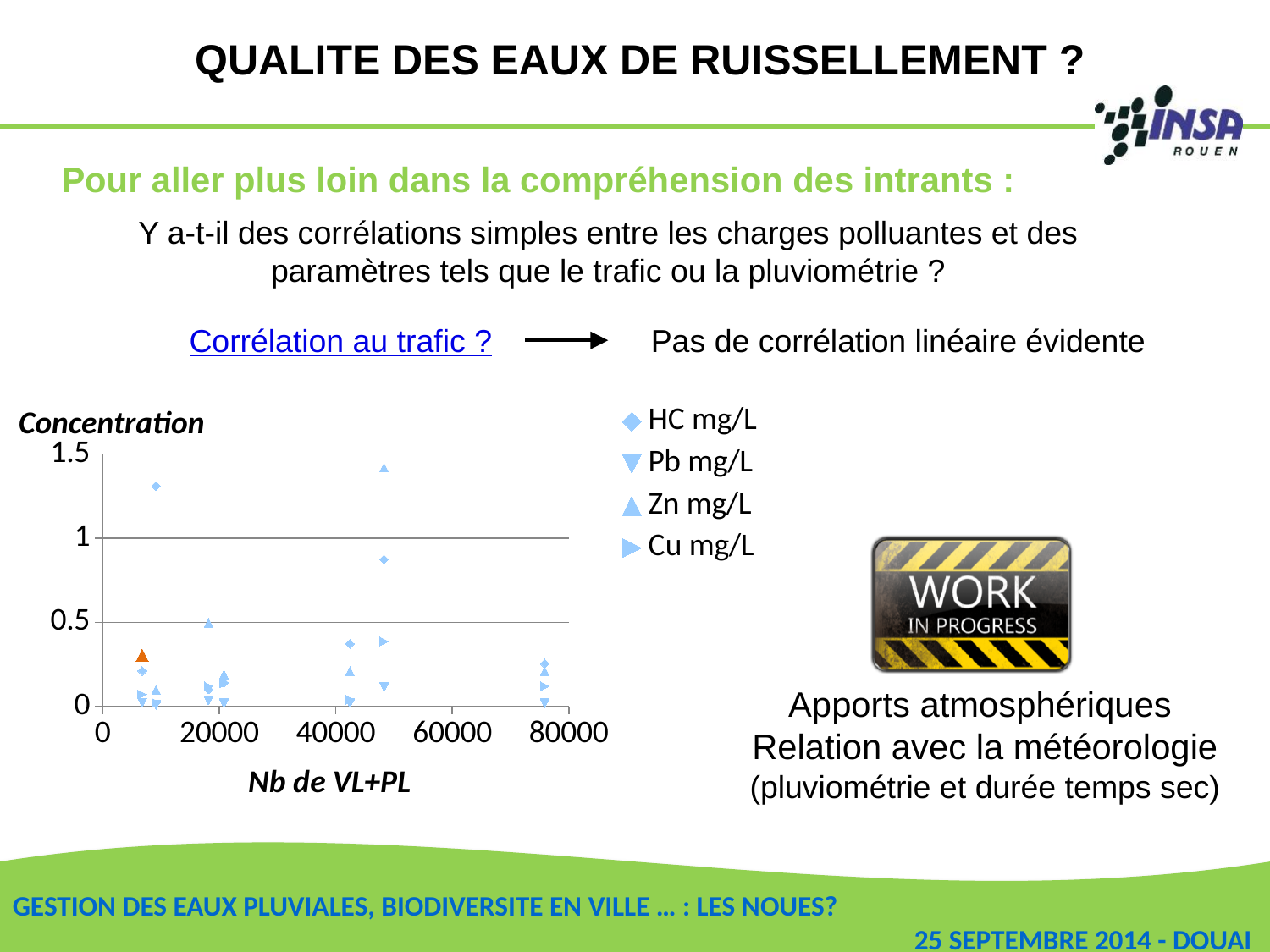
Is the highest HC mg/L point on the chart greater or less than 1? greater How many series does the chart legend list? 4 What kind of chart is shown on the slide? Scatter chart What is the highest value shown on the horizontal axis of the chart? 80000 Is the highest Pb mg/L point on the chart greater or less than 0.5? less Is the highest Zn mg/L point on the chart greater or less than 1? greater Which series contains the single highest concentration point on the chart? Zn mg/L What is the label of the horizontal axis of the chart? Nb de VL+PL How many tick labels are shown on the horizontal axis of the chart? 5 What is the highest value shown on the vertical axis of the chart? 1.5 What are the four series listed in the chart legend? HC mg/L, Pb mg/L, Zn mg/L, Cu mg/L